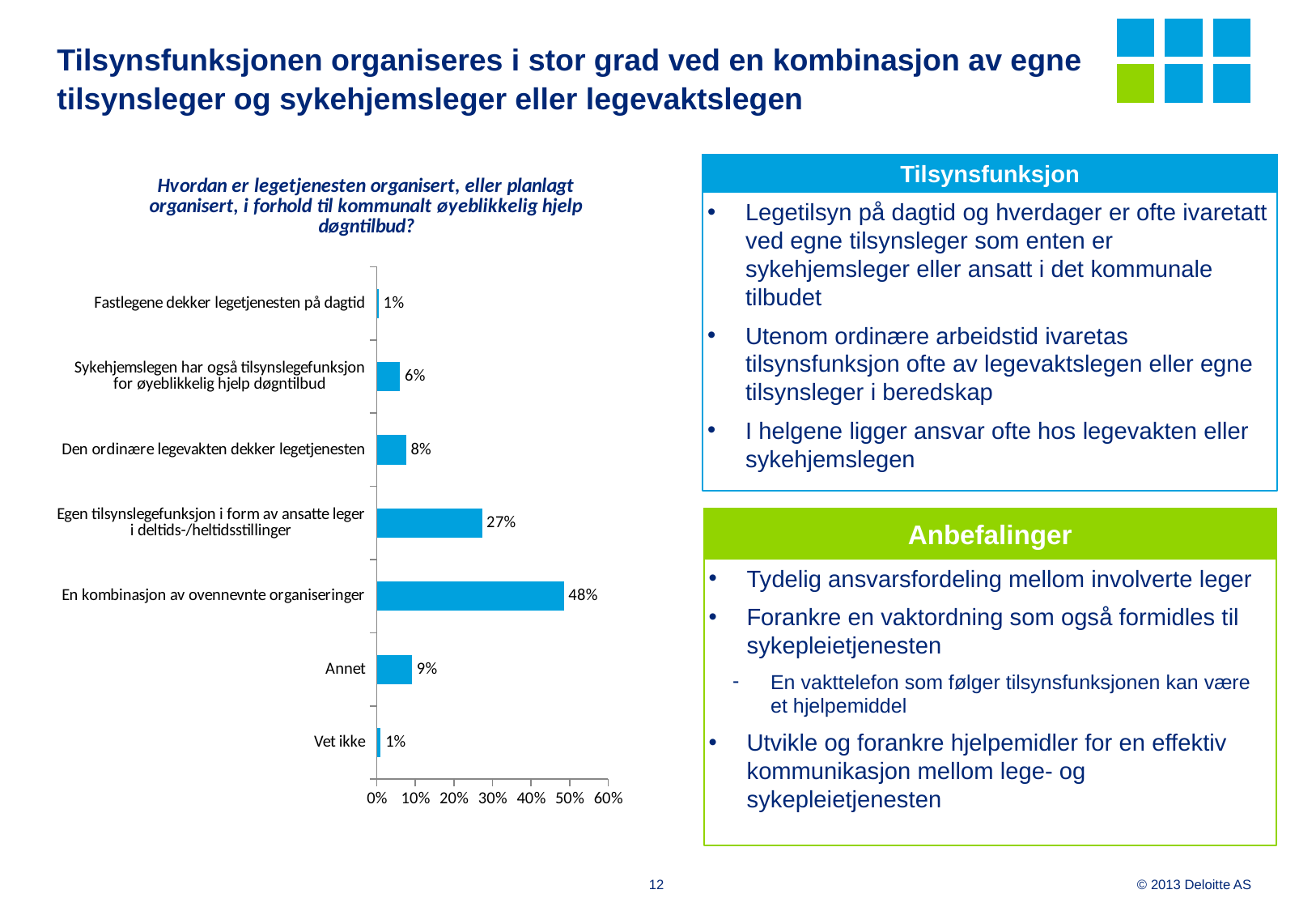
What is the value for "Den ordinære legevakten dekker legetjenesten"? 8% What kind of chart is shown on the slide? bar chart How many categories are shown in the chart? 7 Which category has the highest value? En kombinasjon av ovennevnte organiseringer What is the value for "Sykehjemslegen har også tilsynslegefunksjon for øyeblikkelig hjelp døgntilbud"? 6% What is the value for "Egen tilsynslegefunksjon i form av ansatte leger i deltids-/heltidsstillinger"? 27% What is the value for "Annet"? 9% What is the difference between the values for "En kombinasjon av ovennevnte organiseringer" and "Egen tilsynslegefunksjon i form av ansatte leger i deltids-/heltidsstillinger"? 21% Is the value for "En kombinasjon av ovennevnte organiseringer" greater or less than 40%? greater Which is larger, the value for "Annet" or the value for "Sykehjemslegen har også tilsynslegefunksjon for øyeblikkelig hjelp døgntilbud"? Annet What is the difference between the values for "Annet" and "Den ordinære legevakten dekker legetjenesten"? 1% What is the value for "En kombinasjon av ovennevnte organiseringer"? 48%